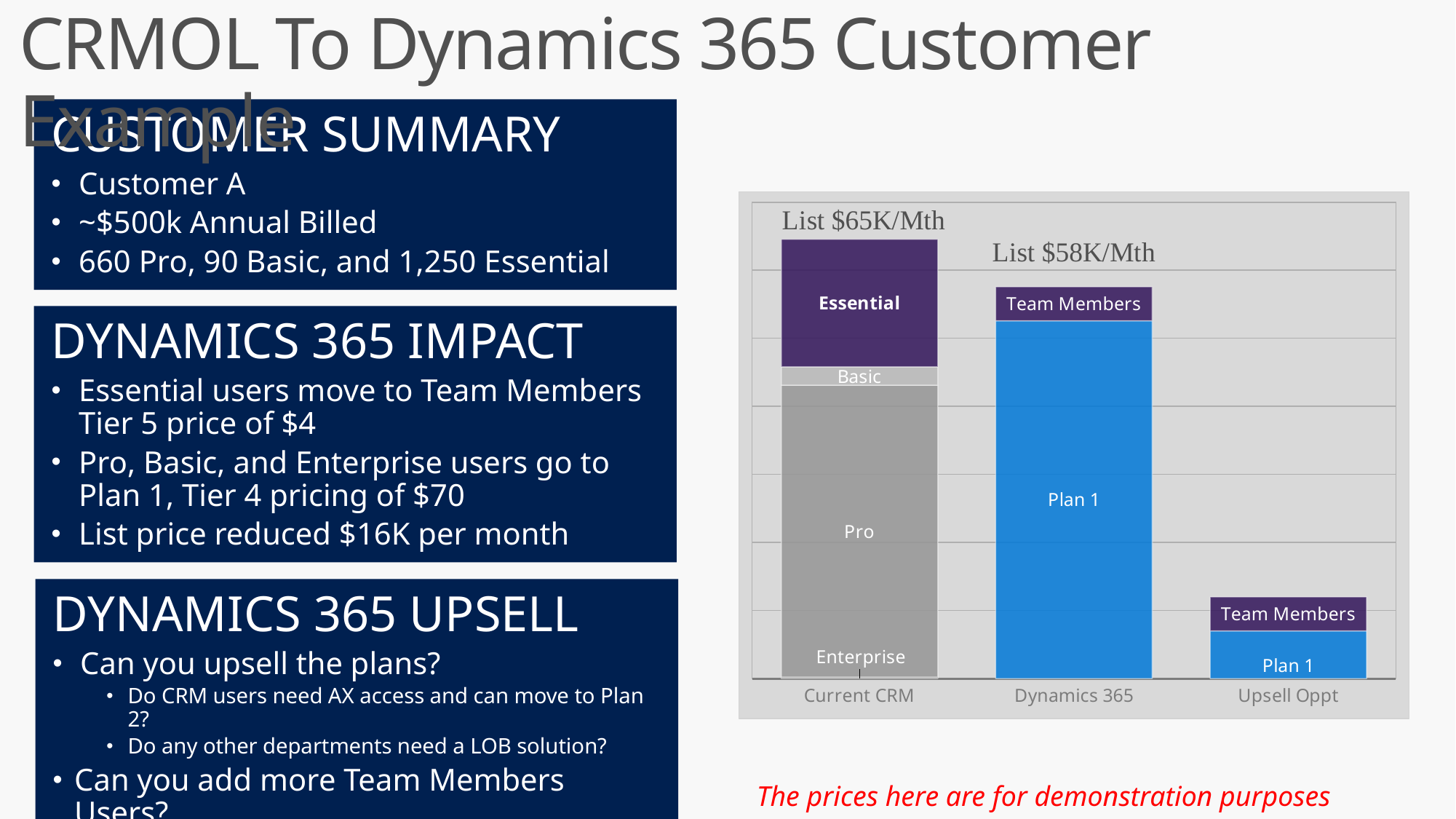
What list price per month is shown above the Dynamics 365 bar? List $58K/Mth Which segment is the largest within the Dynamics 365 bar? Plan 1 What is the difference between the list price shown for Current CRM and the list price shown for Dynamics 365? $7K/Mth Which category has the tallest bar in the chart? Current CRM What kind of chart is shown on the slide? Stacked bar chart What list price per month is shown above the Current CRM bar? List $65K/Mth Which two segments make up the Dynamics 365 bar? Plan 1 and Team Members Which category has the shortest bar in the chart? Upsell Oppt Which bar is taller, Dynamics 365 or Upsell Oppt? Dynamics 365 Which bar is taller, Current CRM or Dynamics 365? Current CRM Which segments make up the Current CRM bar, from bottom to top? Enterprise, Pro, Basic, Essential How many categories are shown on the x axis of the chart? 3